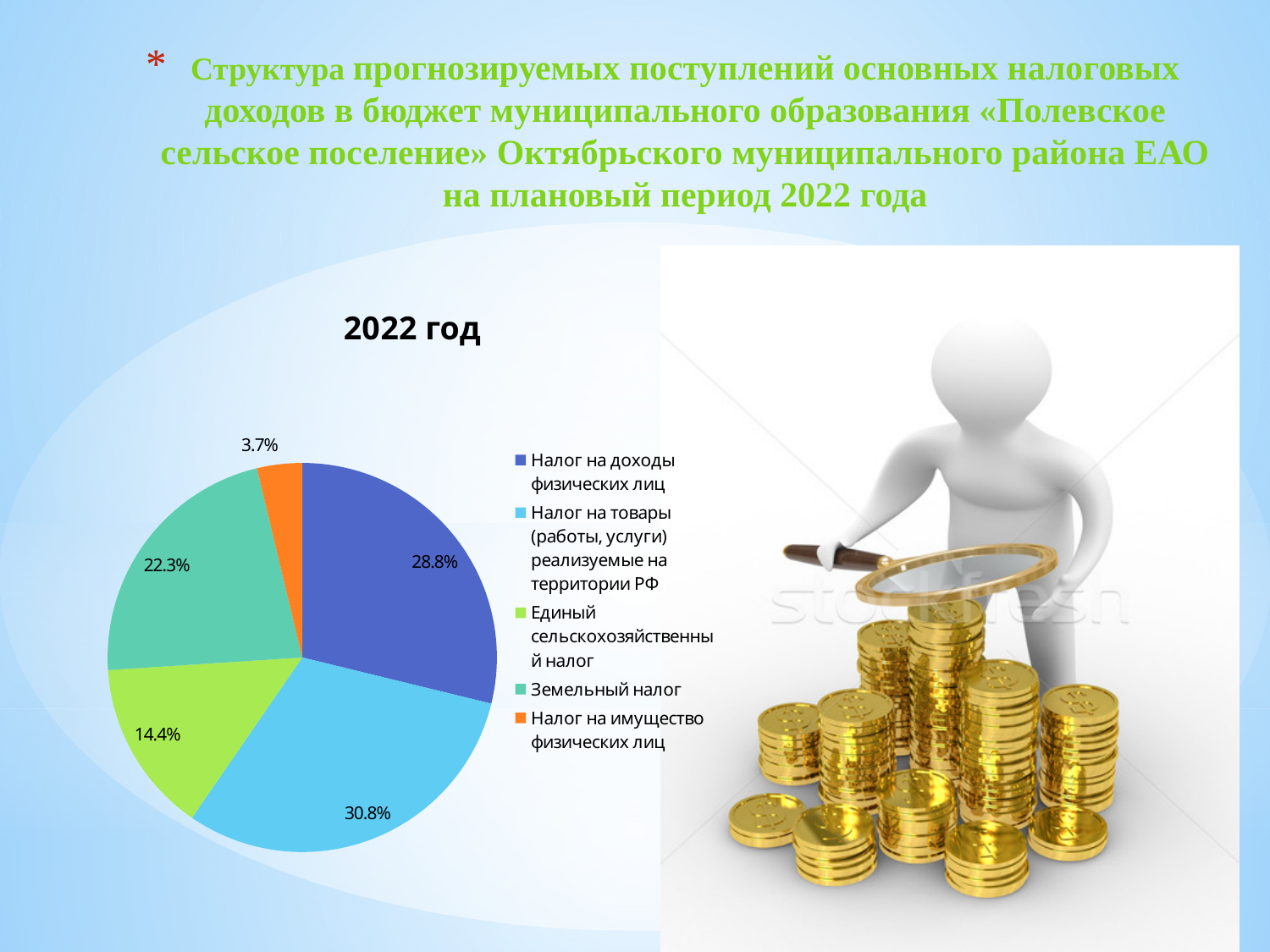
What share does Налог на имущество физических лиц have in the pie chart? 3.7% Which is larger: the share of Земельный налог or the share of Единый сельскохозяйственный налог? Земельный налог What share does Налог на доходы физических лиц have in the pie chart? 28.8% What type of chart is shown on the slide? pie chart How many slices does the pie chart have? 5 Which category has the smallest share of the pie? Налог на имущество физических лиц What share does Единый сельскохозяйственный налог have in the pie chart? 14.4% How many entries does the legend list? 5 What share does Земельный налог have in the pie chart? 22.3% What is the title of the chart? 2022 год Which category has the largest share of the pie? Налог на товары (работы, услуги) реализуемые на территории РФ What is the difference between the shares of Налог на товары (работы, услуги) реализуемые на территории РФ and Налог на доходы физических лиц? 2.0%